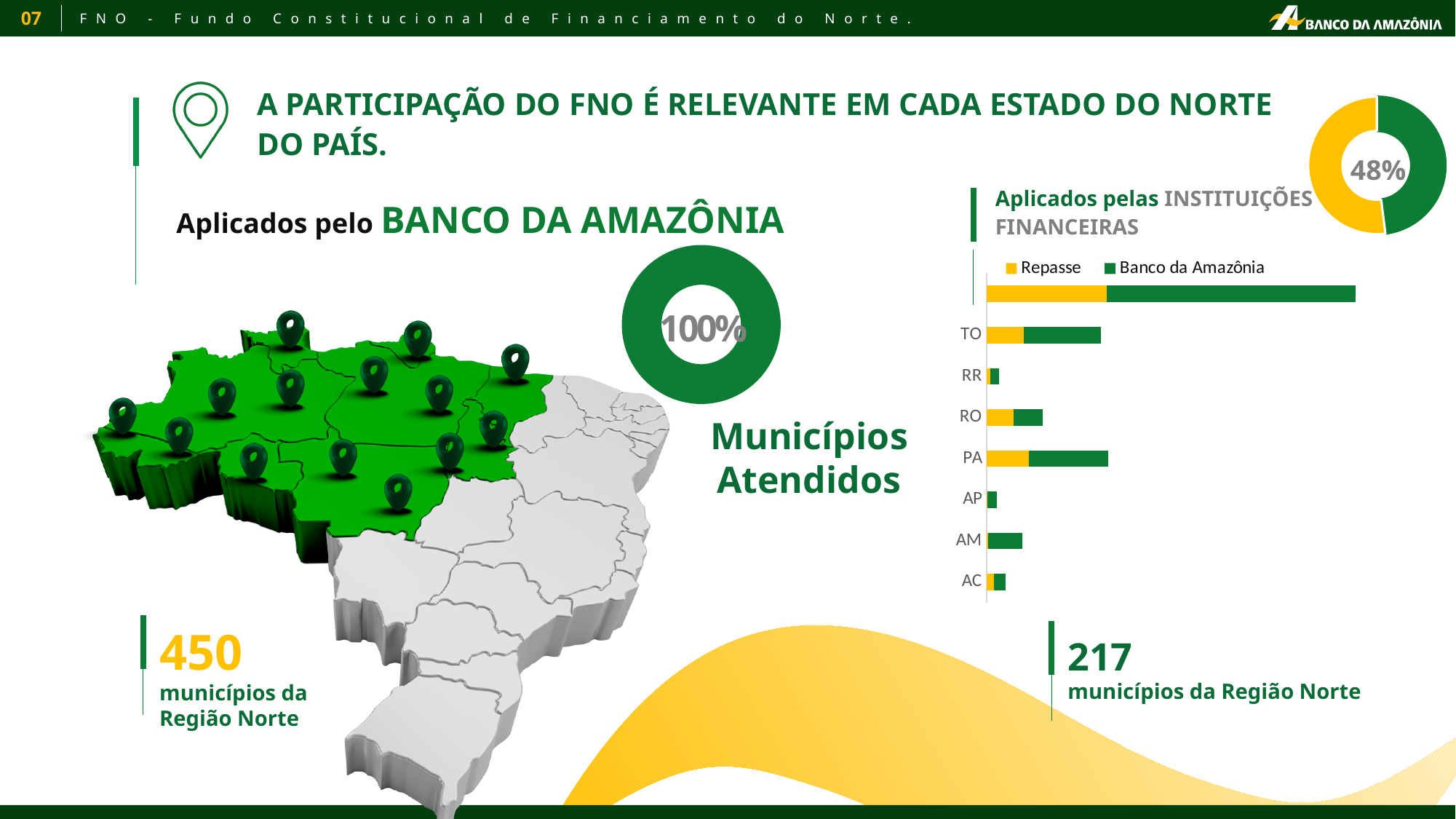
How many state labels (TO, RR, RO, PA, AP, AM, AC) appear on the vertical axis of the stacked bar chart? 7 In the stacked bar chart, which has the longer total bar, TO or RO? TO In the stacked bar chart, which series is shown in green? Banco da Amazônia In the stacked bar chart, which series is shown in yellow? Repasse In the stacked bar chart, which has the longer total bar, AM or RR? AM In the stacked bar chart, which has the longer total bar, RO or AP? RO How many series does the legend of the stacked bar chart list? 2 What percentage is shown in the donut chart in the top right corner of the slide? 48% What kind of chart is the chart with the legend entries Repasse and Banco da Amazônia? bar chart What percentage is shown in the donut chart labelled Municípios Atendidos? 100%